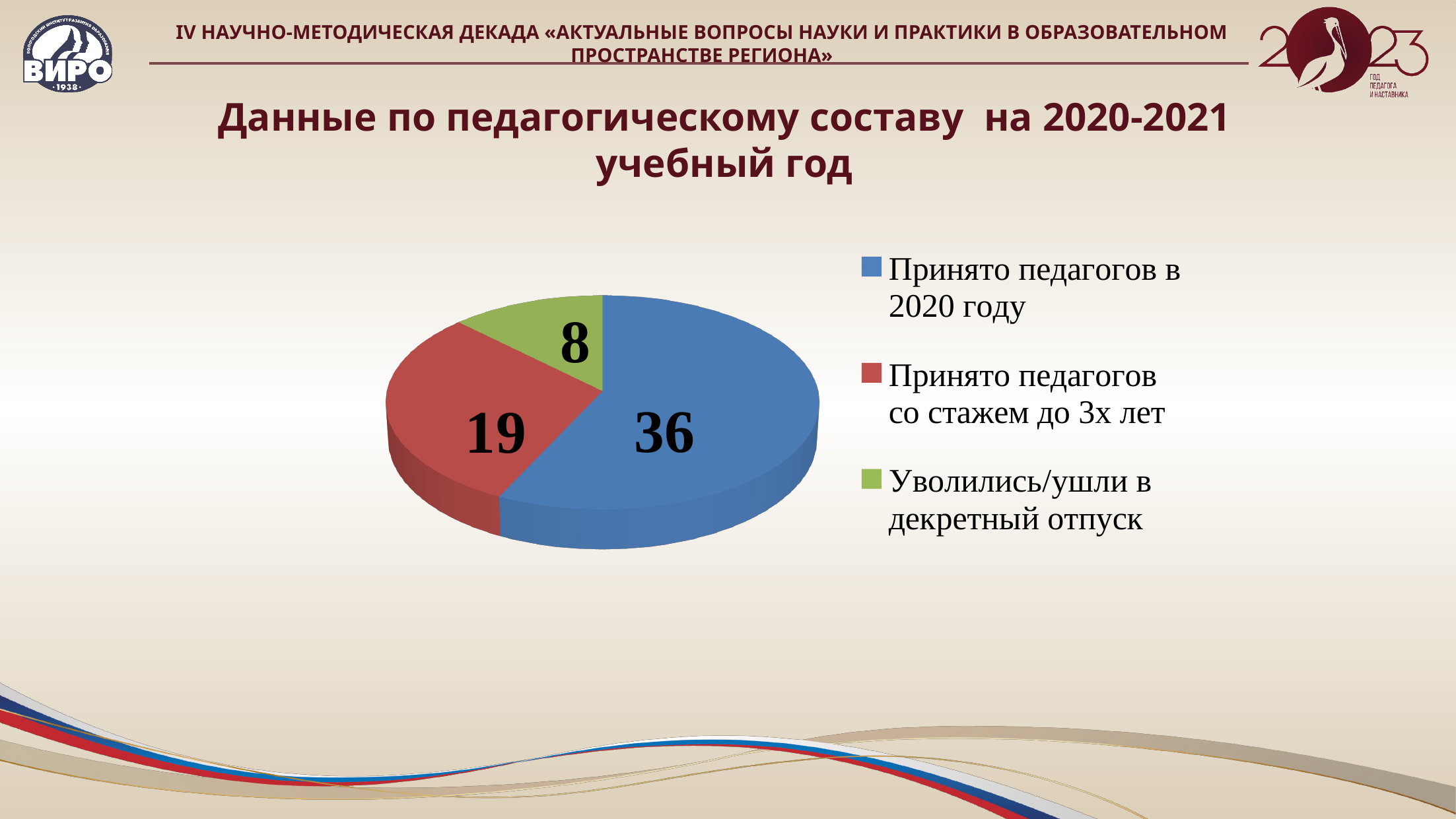
How many slices does the pie chart have? 3 What is the total of all the values shown in the pie chart? 63 What type of chart is shown on the slide? pie chart What is the value for "Принято педагогов со стажем до 3х лет"? 19 Which is larger: the value for "Принято педагогов со стажем до 3х лет" or the value for "Уволились/ушли в декретный отпуск"? Принято педагогов со стажем до 3х лет Which category has the largest slice of the pie? Принято педагогов в 2020 году What is the difference between the value for "Принято педагогов в 2020 году" and the value for "Принято педагогов со стажем до 3х лет"? 17 What is the difference between the value for "Принято педагогов со стажем до 3х лет" and the value for "Уволились/ушли в декретный отпуск"? 11 What is the value for "Уволились/ушли в декретный отпуск"? 8 What is the value for "Принято педагогов в 2020 году"? 36 What colour is the slice for "Уволились/ушли в декретный отпуск"? green Which category has the smallest slice of the pie? Уволились/ушли в декретный отпуск